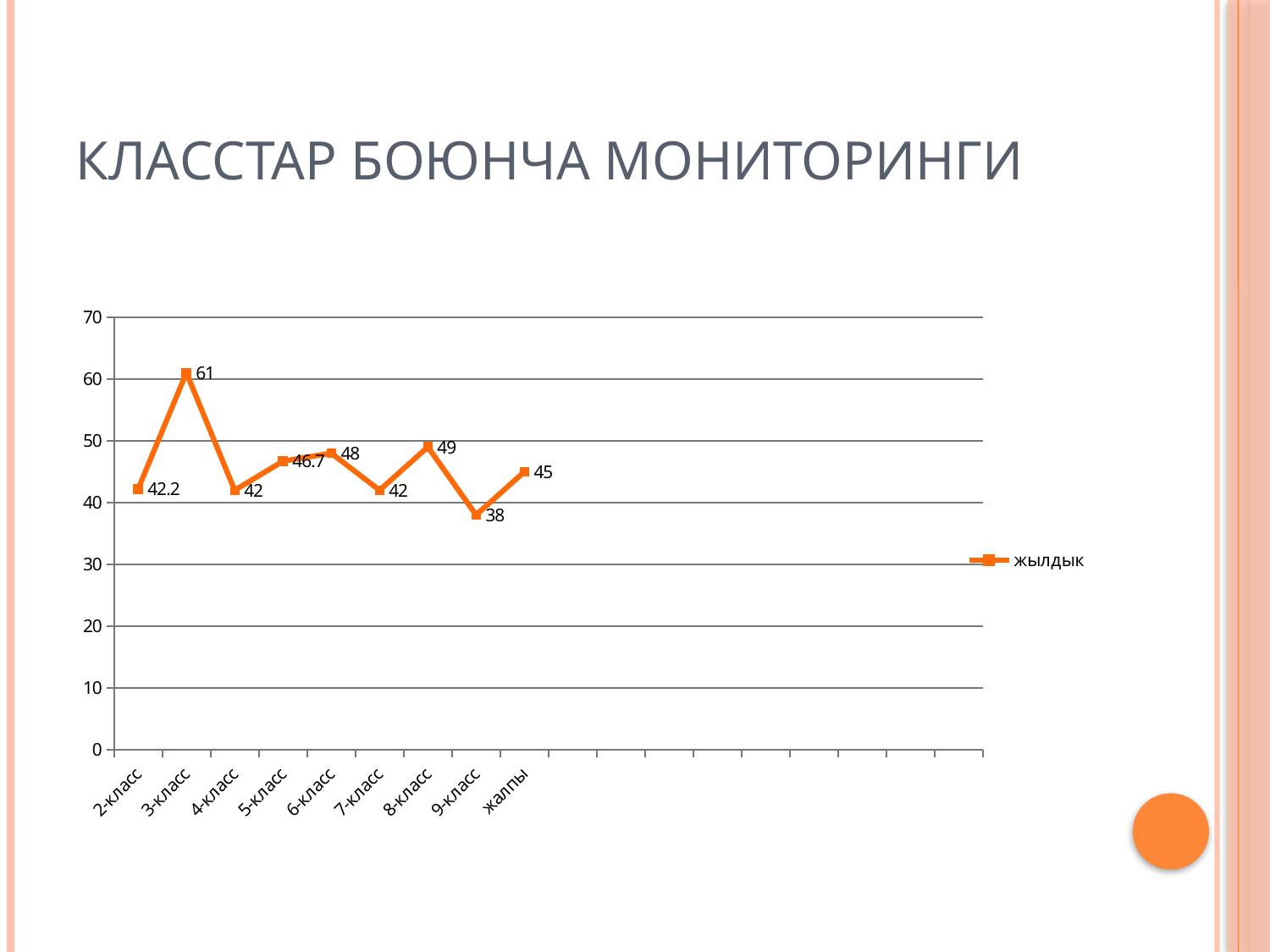
How many categories are plotted on the x axis? 9 Which category has the lowest value? 9-класс What kind of chart is shown on the slide? line chart What is the value for 5-класс? 46.7 Which category has the highest value? 3-класс Which is larger, the value for 8-класс or the value for 6-класс? 8-класс How many series does the legend list? 1 What is the value for 3-класс? 61 What is the difference between the values for 3-класс and 9-класс? 23 What is the value for жалпы? 45 What is the name of the series shown in the legend? жылдык What is the value for 2-класс? 42.2